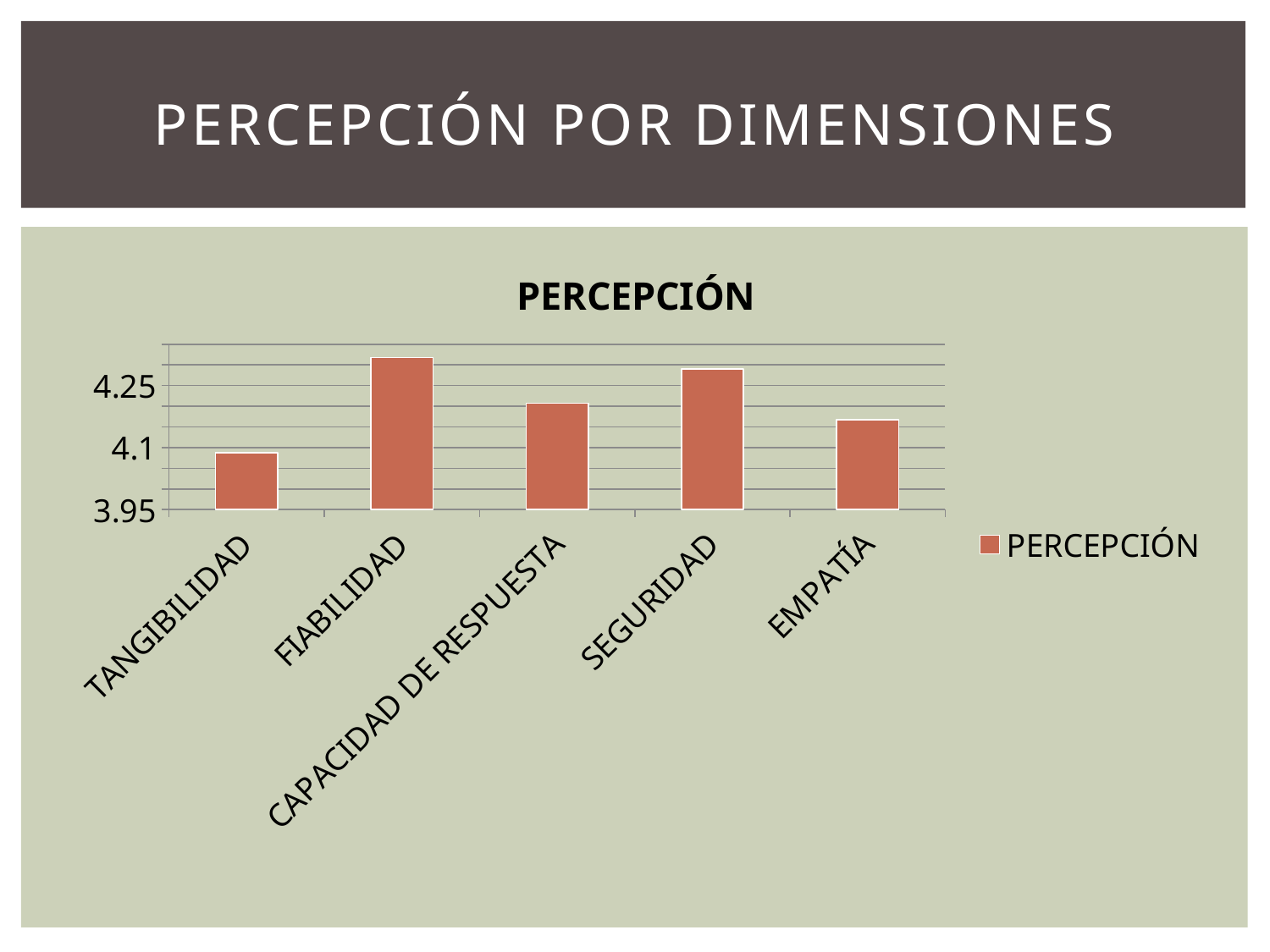
How many series does the legend list? 1 Which is larger, the value for EMPATÍA or the value for TANGIBILIDAD? EMPATÍA Is the value for CAPACIDAD DE RESPUESTA greater or less than 4.25? less Is the value for EMPATÍA greater or less than 4.1? greater What kind of chart is shown on the slide? bar chart Which category has the lowest value in the chart? TANGIBILIDAD Is the value for FIABILIDAD greater or less than 4.25? greater What is the title of the chart? PERCEPCIÓN Which is larger, the value for FIABILIDAD or the value for CAPACIDAD DE RESPUESTA? FIABILIDAD How many categories are plotted in the chart? 5